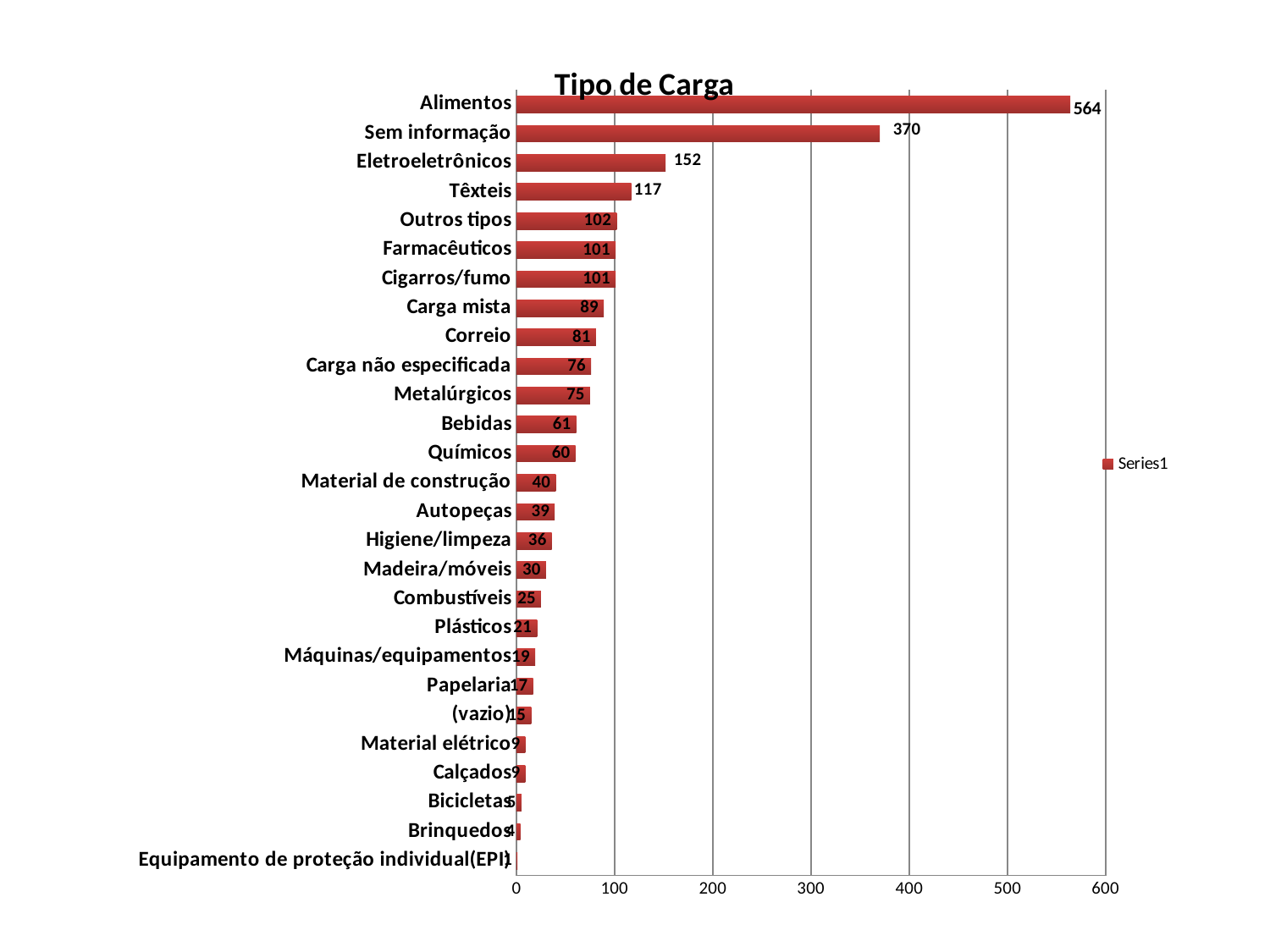
What is the value for Alimentos? 564 How many categories are shown in the chart? 27 What is the title of the chart? Tipo de Carga What kind of chart is shown? bar chart Which category has the highest value? Alimentos What is the value for Sem informação? 370 What is the difference between the values for Alimentos and Sem informação? 194 Is the value for Sem informação greater or less than 400? less What is the value for Bebidas? 61 Which is larger, the value for Eletroeletrônicos or the value for Têxteis? Eletroeletrônicos What is the value for Têxteis? 117 How many series does the legend list? 1